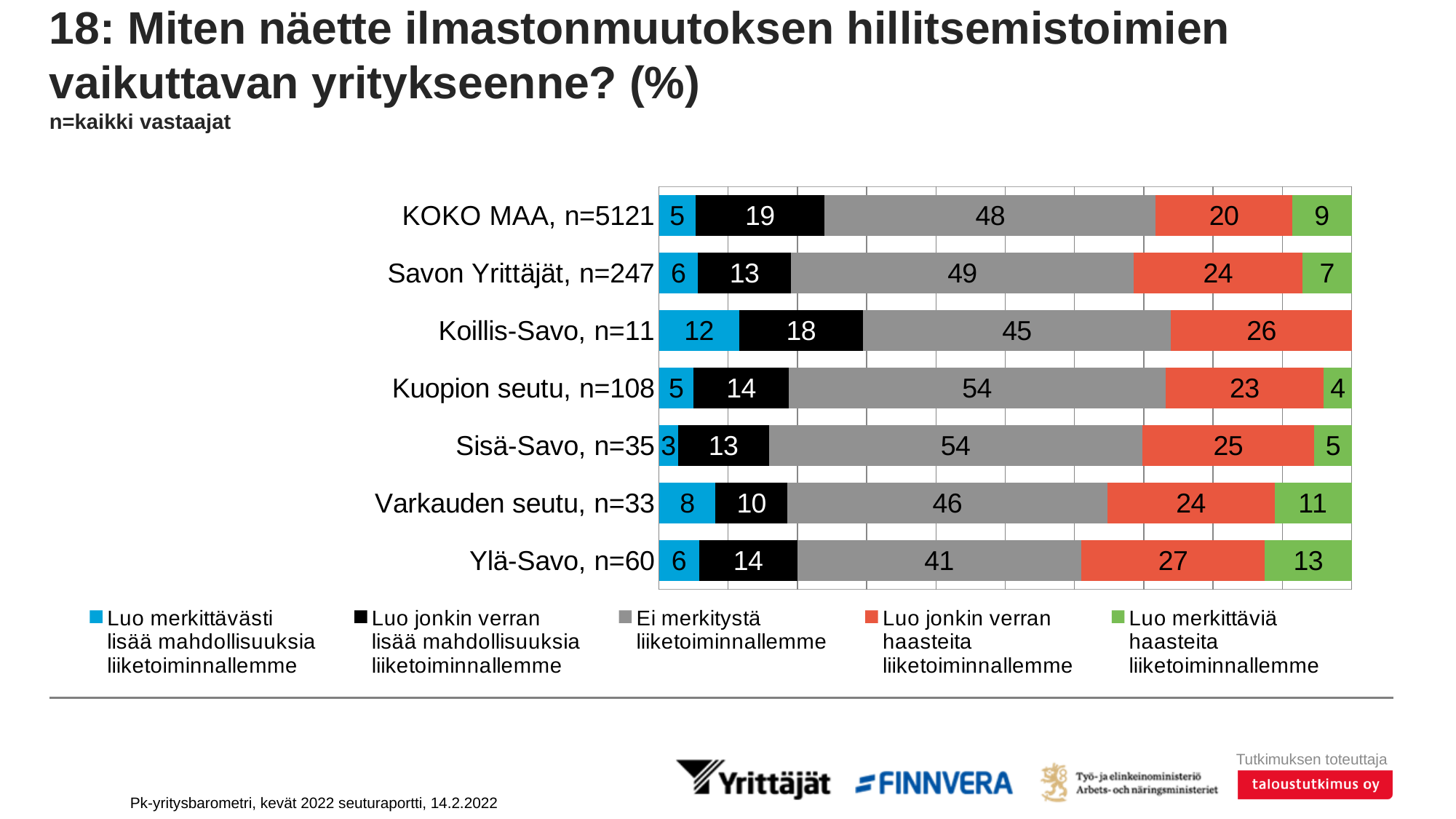
Which category has the lowest value for "Luo merkittävästi lisää mahdollisuuksia liiketoiminnallemme"? Sisä-Savo, n=35 How many series does the legend list? 5 Which category has the highest value for "Luo merkittäviä haasteita liiketoiminnallemme"? Ylä-Savo, n=60 Which has the larger value for "Luo jonkin verran haasteita liiketoiminnallemme": KOKO MAA, n=5121 or Savon Yrittäjät, n=247? Savon Yrittäjät, n=247 What is the difference between the "Ei merkitystä liiketoiminnallemme" values for KOKO MAA, n=5121 and Ylä-Savo, n=60? 7 What is the value for "Luo jonkin verran haasteita liiketoiminnallemme" for Ylä-Savo, n=60? 27 What is the value for "Ei merkitystä liiketoiminnallemme" for KOKO MAA, n=5121? 48 What is the total of the stacked bar for Kuopion seutu, n=108? 100 What kind of chart is shown on the slide? Stacked bar chart Which category has the lowest value for "Ei merkitystä liiketoiminnallemme"? Ylä-Savo, n=60 How many categories are shown on the chart? 7 What is the value for "Luo merkittävästi lisää mahdollisuuksia liiketoiminnallemme" for Koillis-Savo, n=11? 12